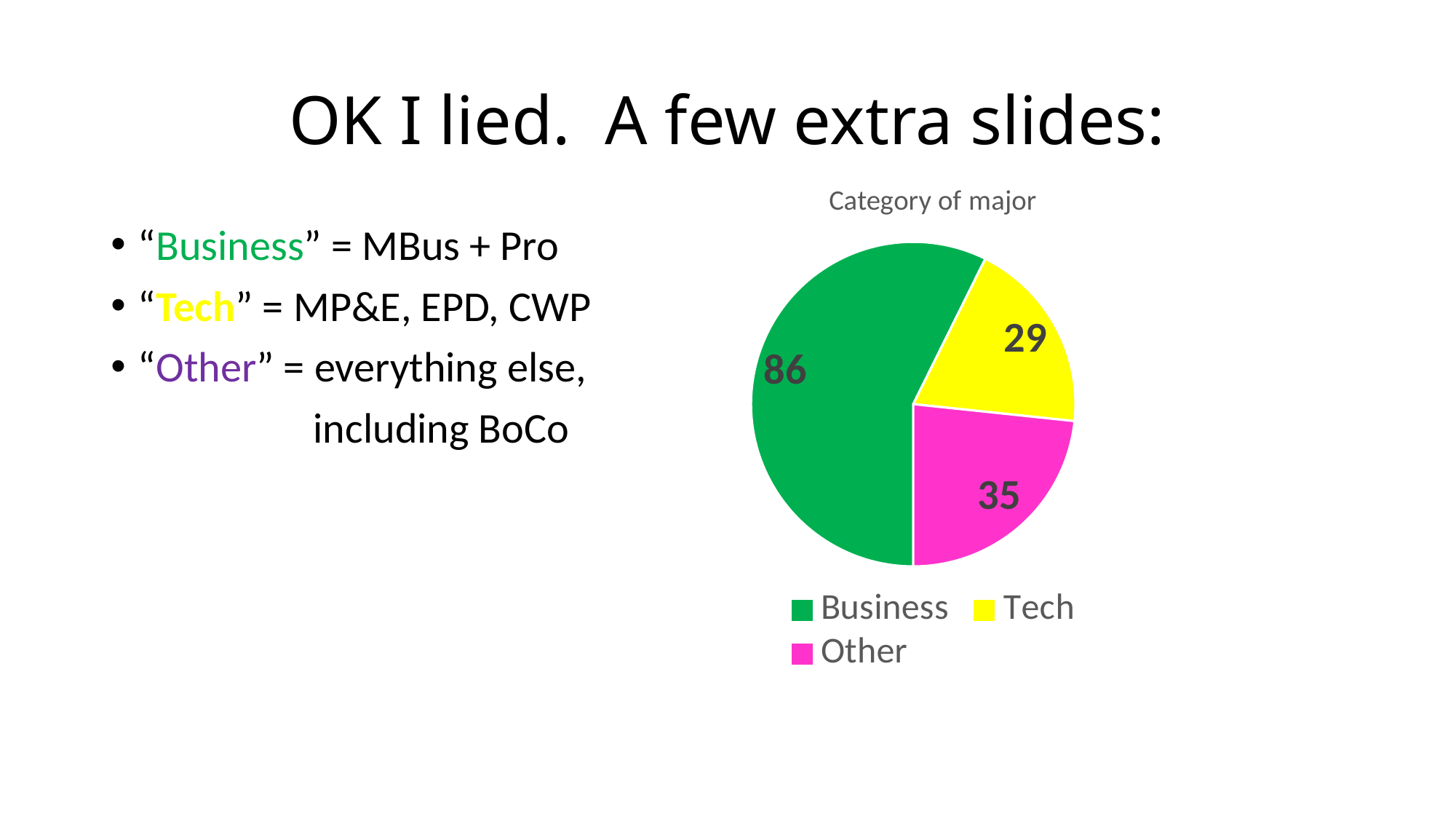
What is the difference between the Business value and the Other value? 51 What is the value for Business in the pie chart? 86 How many categories does the pie chart show? 3 What type of chart is shown on the slide? pie chart Which colour represents Tech in the pie chart? yellow Which category has the largest slice of the pie? Business What is the title of the chart? Category of major What is the value for Tech in the pie chart? 29 Which category has the smallest slice of the pie? Tech What is the value for Other in the pie chart? 35 Which is larger, the value for Other or the value for Tech? Other What is the total of all the values in the pie chart? 150